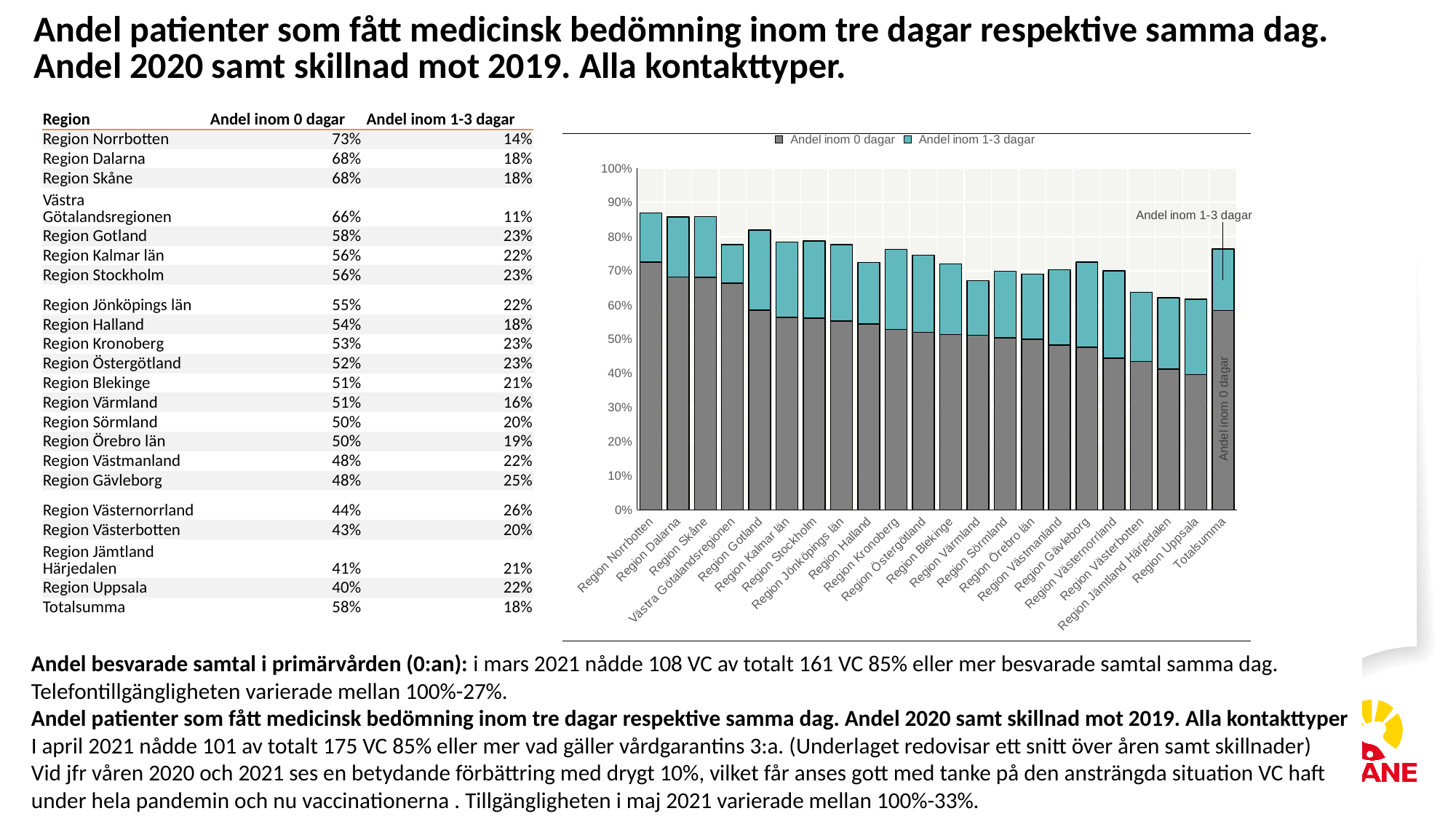
What kind of chart is shown on the slide? stacked bar chart What is the 'Andel inom 0 dagar' value for Region Gotland? 58% What is the total height of the stacked bar for Region Norrbotten (0 dagar plus 1-3 dagar)? 87% What is the 'Andel inom 1-3 dagar' value for Region Gävleborg? 25% How many bars (categories) are plotted along the x axis of the chart? 22 Which is larger, the 'Andel inom 1-3 dagar' value for Region Gotland or for Region Norrbotten? Region Gotland How many series does the chart legend list? 2 Moving from left to right across the regions (excluding Totalsumma), do the 'Andel inom 0 dagar' bars rise or fall? fall Which region has the highest value for 'Andel inom 0 dagar'? Region Norrbotten What is the difference in 'Andel inom 0 dagar' between Region Norrbotten and Region Uppsala? 33 percentage points Which region has the lowest value for 'Andel inom 0 dagar'? Region Uppsala Is the 'Andel inom 0 dagar' value for Region Uppsala greater or less than 50%? less